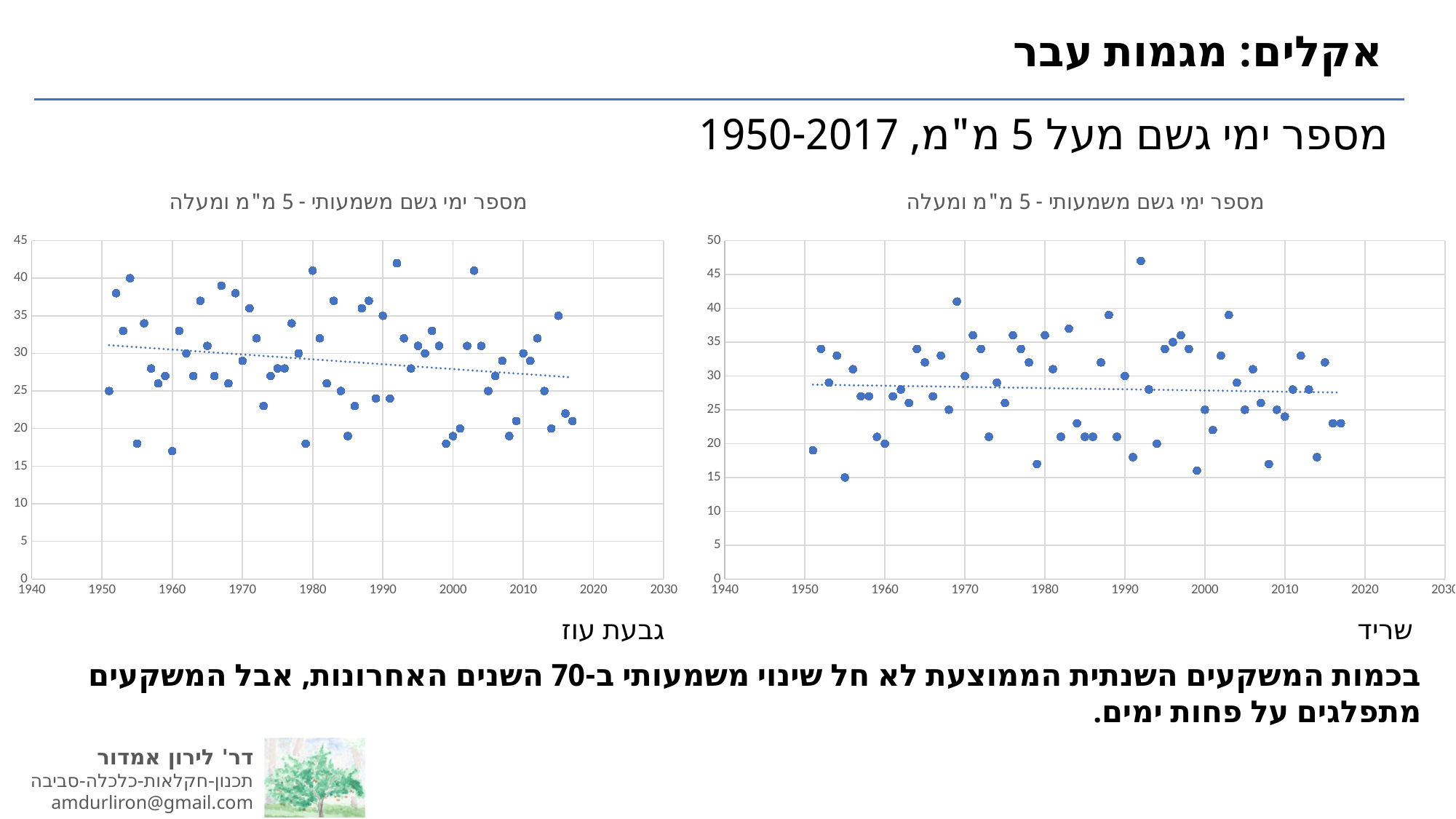
In the right chart (שריד), is the value for 1992 greater or less than 45? greater What is the highest value shown on the y-axis of the right chart (שריד)? 50 What kind of chart is the left chart (גבעת עוז)? scatter chart In the right chart (שריד), which year has the highest value? 1992 How many charts are shown on the slide? 2 In the left chart (גבעת עוז), does the dotted trend line rise or fall from 1950 to 2017? fall What kind of chart is the right chart (שריד)? scatter chart In the right chart (שריד), is the value for 1999 greater or less than 20? less In the left chart (גבעת עוז), is the value for 1992 greater or less than 40? greater What is the title of the left chart (גבעת עוז)? מספר ימי גשם משמעותי - 5 מ"מ ומעלה In the right chart (שריד), does the dotted trend line rise or fall from 1950 to 2017? fall